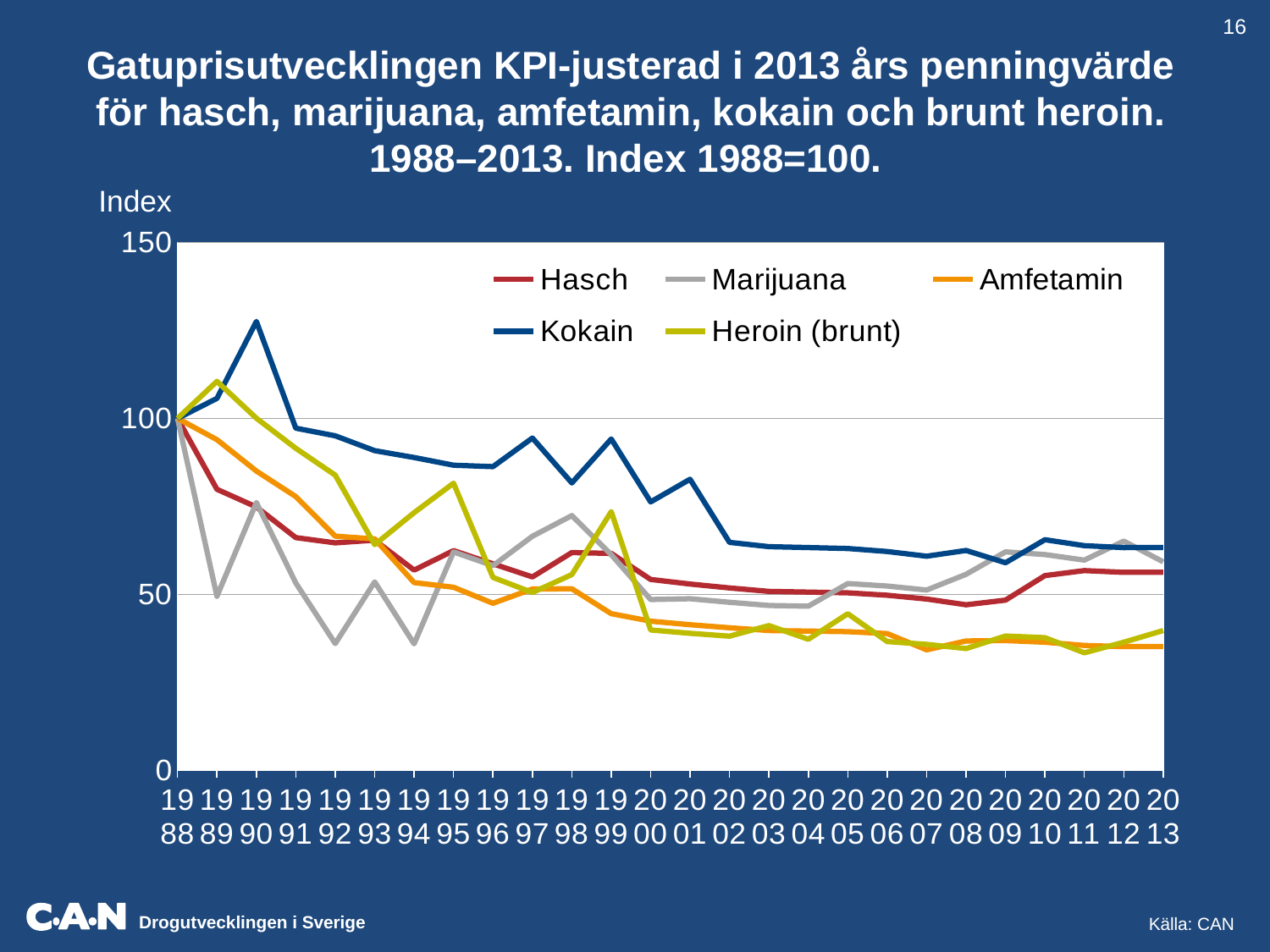
How many years are plotted along the x axis? 26 Is the value for Marijuana in 1992 greater or less than 50? less What kind of chart is shown on the slide? line chart Which series has the highest value in 1990? Kokain What is the index value for Kokain in 1988? 100 Is the value for Kokain in 1990 greater or less than 100? greater Is the value for Amfetamin in 2013 greater or less than 50? less How many series does the legend list? 5 In 2013, which is larger: the value for Kokain or the value for Hasch? Kokain Which series has the lowest value in 1992? Marijuana Does the Amfetamin series generally rise or fall from 1988 to 2013? fall